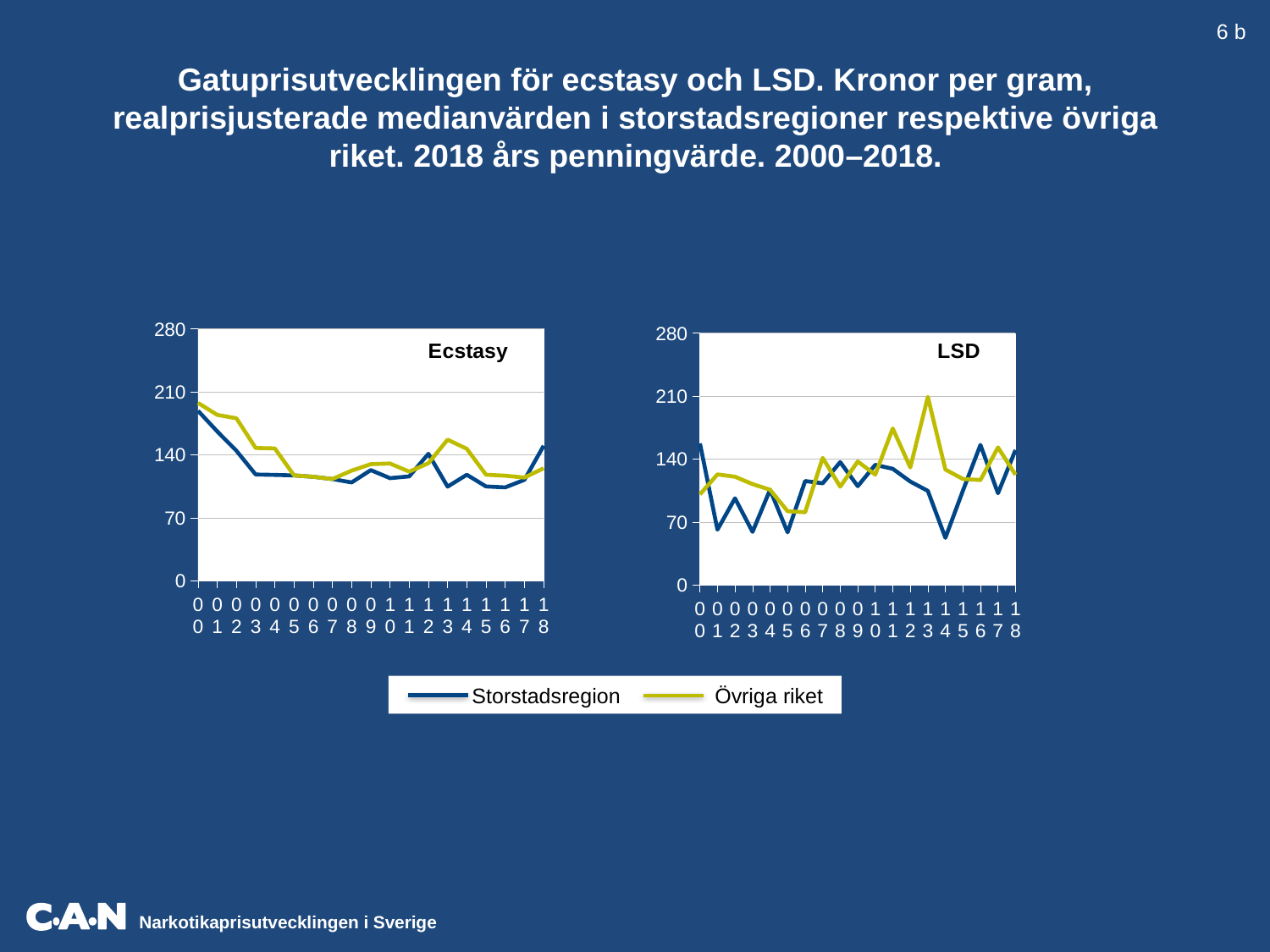
In the LSD chart, is the Storstadsregion value for 2014 greater or less than 70? less In the Ecstasy chart, does the Övriga riket series overall rise or fall from 2000 to 2018? fall In the LSD chart, which series is higher in 2013, Storstadsregion or Övriga riket? Övriga riket In the Ecstasy chart, is the Storstadsregion value for 2000 greater or less than 210? less What kind of chart is the Ecstasy chart? line chart What are the two series named in the legend? Storstadsregion and Övriga riket In the Ecstasy chart, which year has the highest Övriga riket value? 2000 In the LSD chart, is the Storstadsregion value for 2000 greater or less than 140? greater In the LSD chart, which year has the highest Övriga riket value? 2013 How many series does the legend list? 2 How many years are plotted along the x axis of the LSD chart? 19